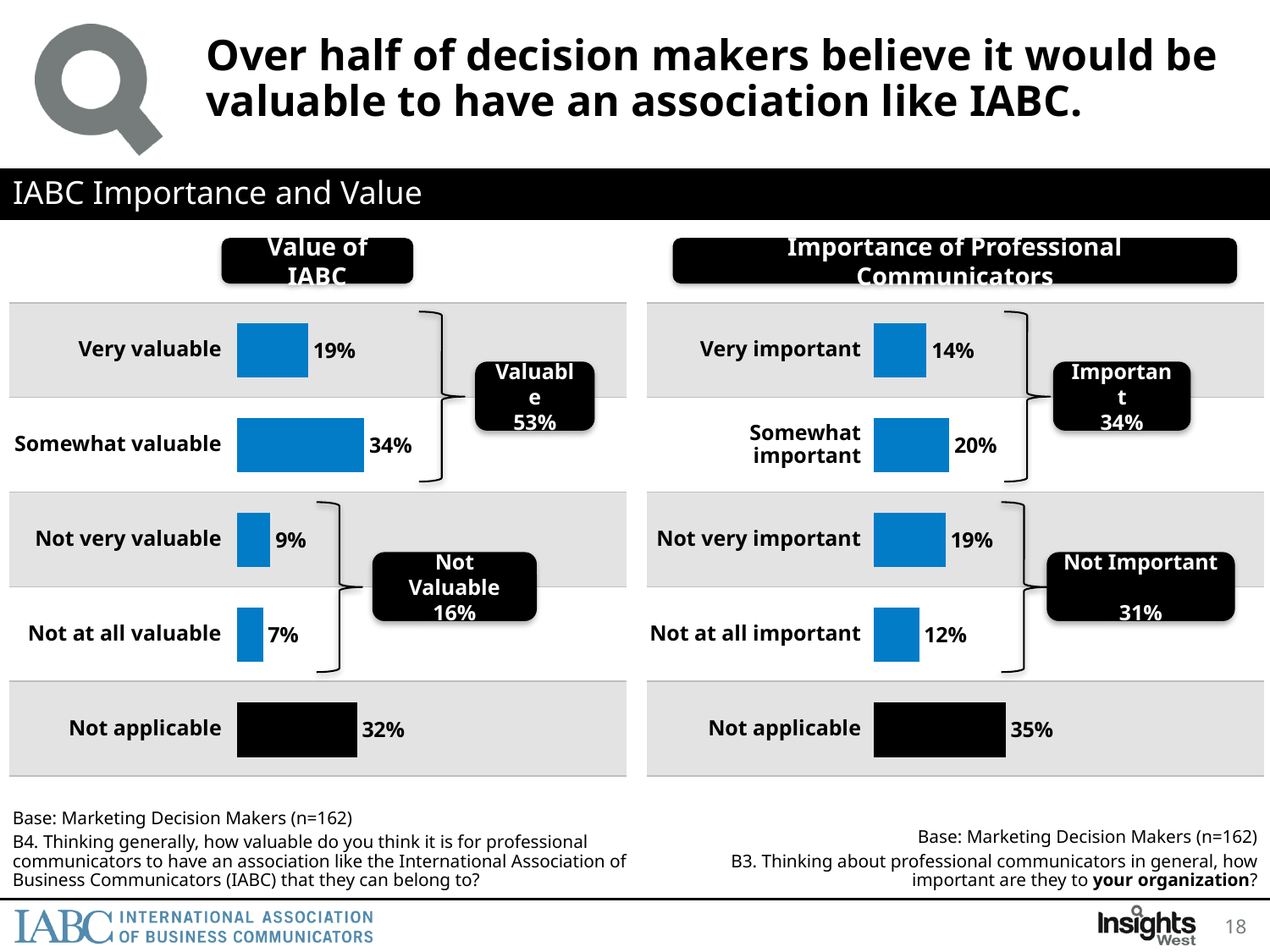
In the 'Importance of Professional Communicators' chart, what percentage said 'Very important'? 14% What type of chart is used in the 'Importance of Professional Communicators' chart? Bar chart In the 'Value of IABC' chart, which category has the highest percentage? Somewhat valuable In the 'Value of IABC' chart, what is the difference between 'Somewhat valuable' and 'Very valuable'? 15% In the 'Importance of Professional Communicators' chart, what combined percentage is labelled 'Not Important'? 31% In the 'Value of IABC' chart, what percentage of respondents said 'Somewhat valuable'? 34% In the 'Importance of Professional Communicators' chart, which category has the lowest percentage? Not at all important In the 'Value of IABC' chart, what percentage said 'Not at all valuable'? 7% In the 'Importance of Professional Communicators' chart, what percentage said 'Not applicable'? 35% How many categories are shown in the 'Value of IABC' chart? 5 In the 'Value of IABC' chart, what combined percentage is labelled 'Valuable'? 53% In the 'Importance of Professional Communicators' chart, which is larger: 'Not very important' or 'Not at all important'? Not very important